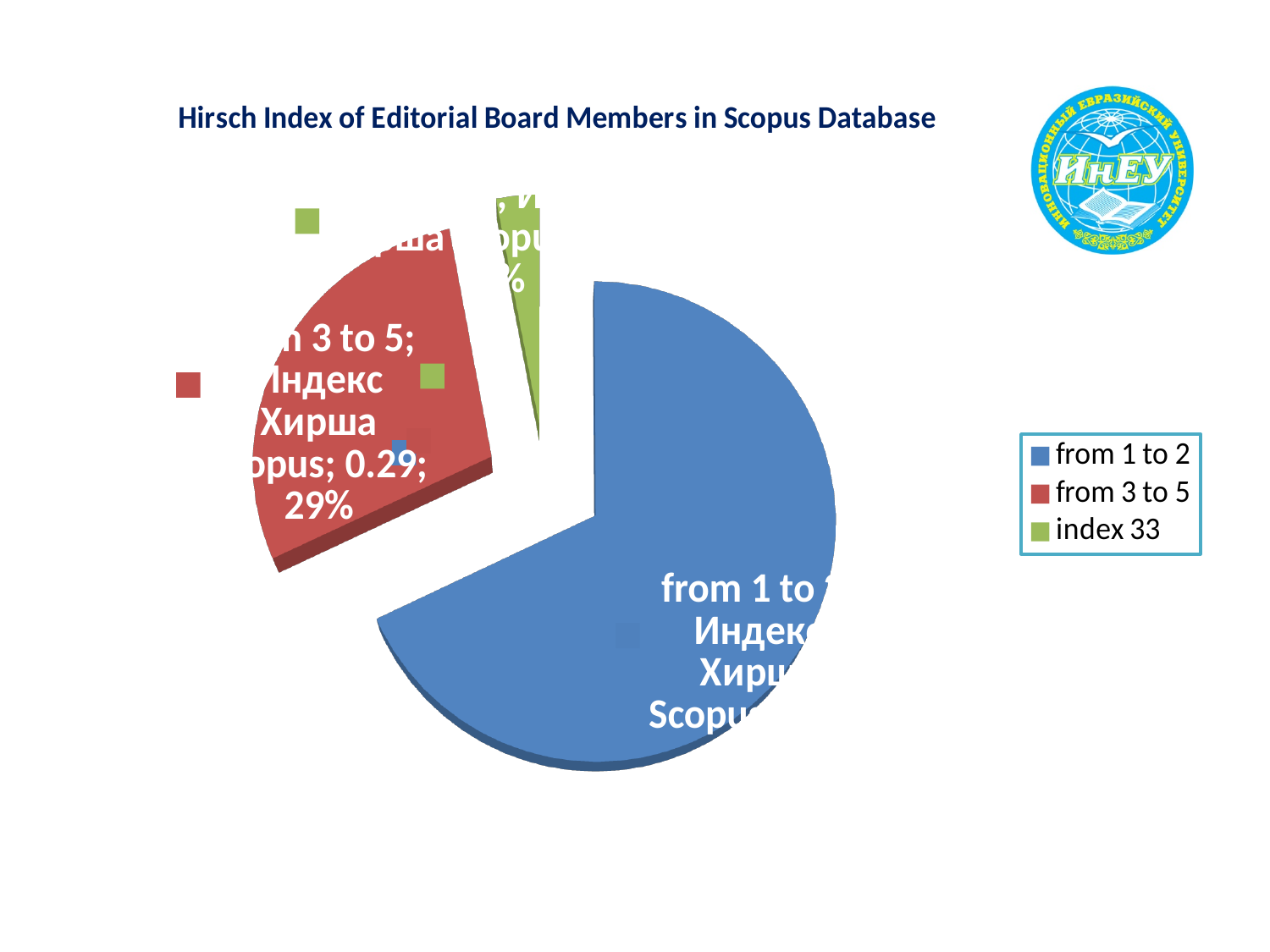
What value is printed on the data label of the 'from 3 to 5' slice? 0.29 How many categories does the legend of the pie chart list? 3 Which slice is larger, 'from 3 to 5' or 'index 33'? from 3 to 5 Which category has the smallest slice of the pie? index 33 Which slice is larger, 'from 1 to 2' or 'from 3 to 5'? from 1 to 2 Which category has the largest slice of the pie? from 1 to 2 What colour is the 'from 1 to 2' slice in the pie chart? blue What kind of chart is shown on the slide? pie chart What is the title of the chart? Hirsch Index of Editorial Board Members in Scopus Database What share of the pie does the 'from 3 to 5' slice represent? 29%